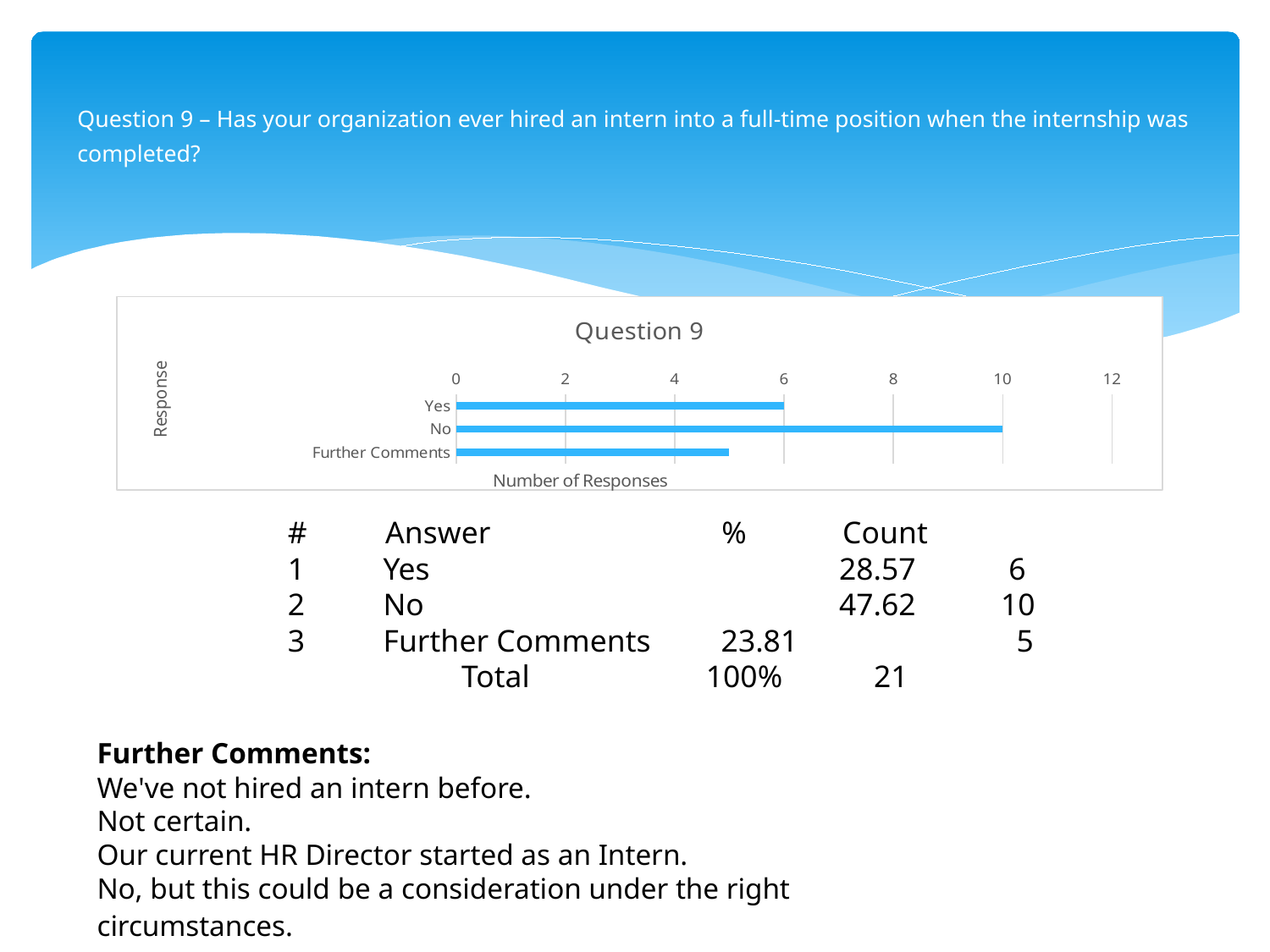
What is the number of responses for Yes in the chart? 6 Is the value for No greater or less than 8? greater Which has more responses, Yes or Further Comments? Yes How many response categories are plotted in the chart? 3 Is the value for Further Comments greater or less than 6? less What is the label on the horizontal axis of the chart? Number of Responses Which response category has the highest number of responses? No What type of chart is shown on the slide? bar chart What is the difference in number of responses between No and Yes? 4 What is the title of the chart? Question 9 What is the number of responses for No in the chart? 10 Which response category has the lowest number of responses? Further Comments